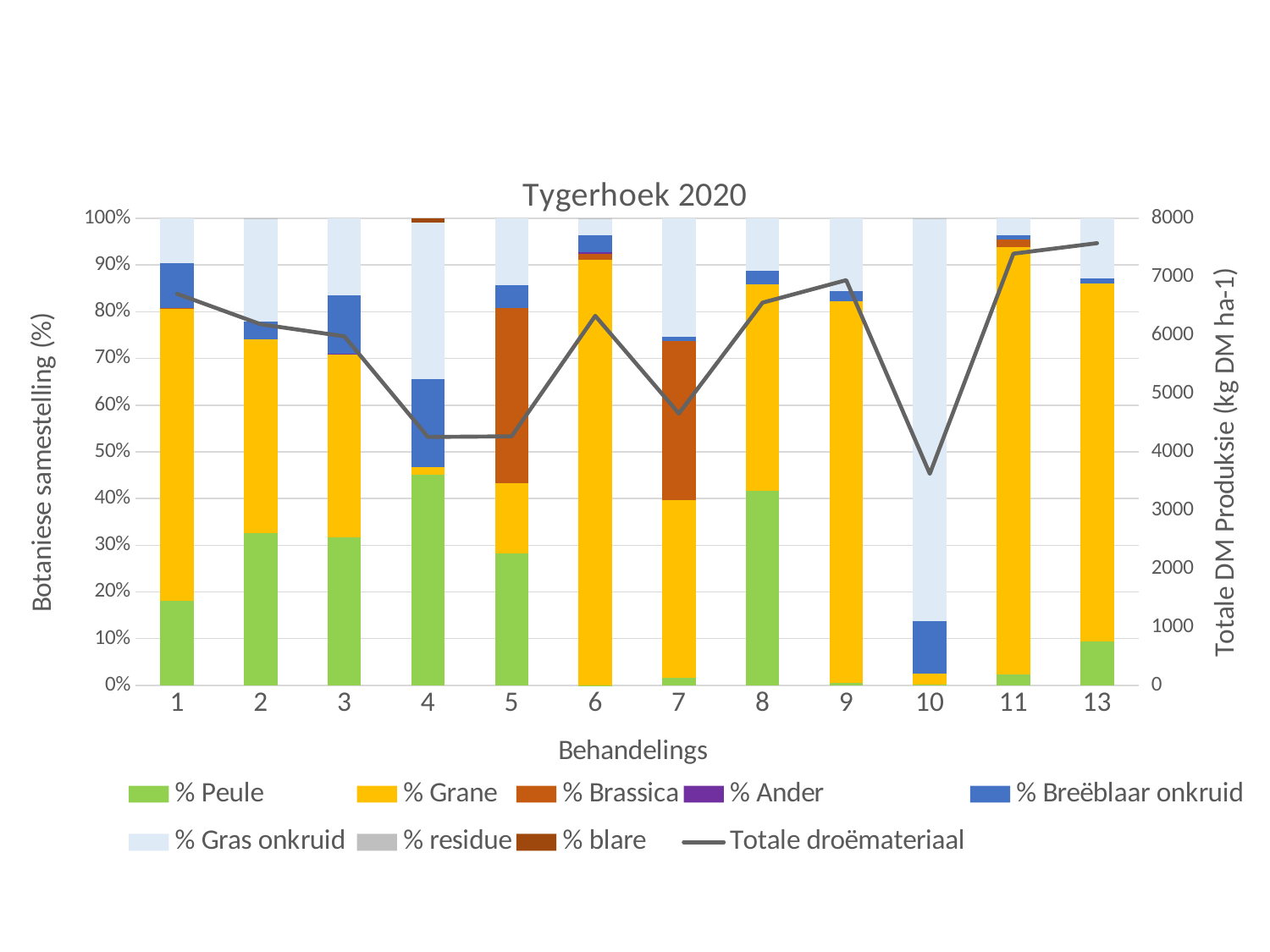
How many series does the legend list? 9 What kind of chart is this? Stacked bar chart with a line Which treatment has the largest % Gras onkruid share? 10 Does the Totale droëmateriaal line rise or fall from treatment 1 to treatment 4? fall Is the Totale droëmateriaal value for treatment 4 greater or less than 5000? less Is the Totale droëmateriaal value for treatment 1 greater or less than 6000? greater Is the % Peule share for treatment 2 larger or smaller than for treatment 1? larger Which treatment has the lowest Totale droëmateriaal value? 10 How many treatments (Behandelings) are shown on the x axis? 12 Is the Totale droëmateriaal value for treatment 10 greater or less than 4000? less What is the title of the chart? Tygerhoek 2020 Which treatment has the largest % Peule share? 4